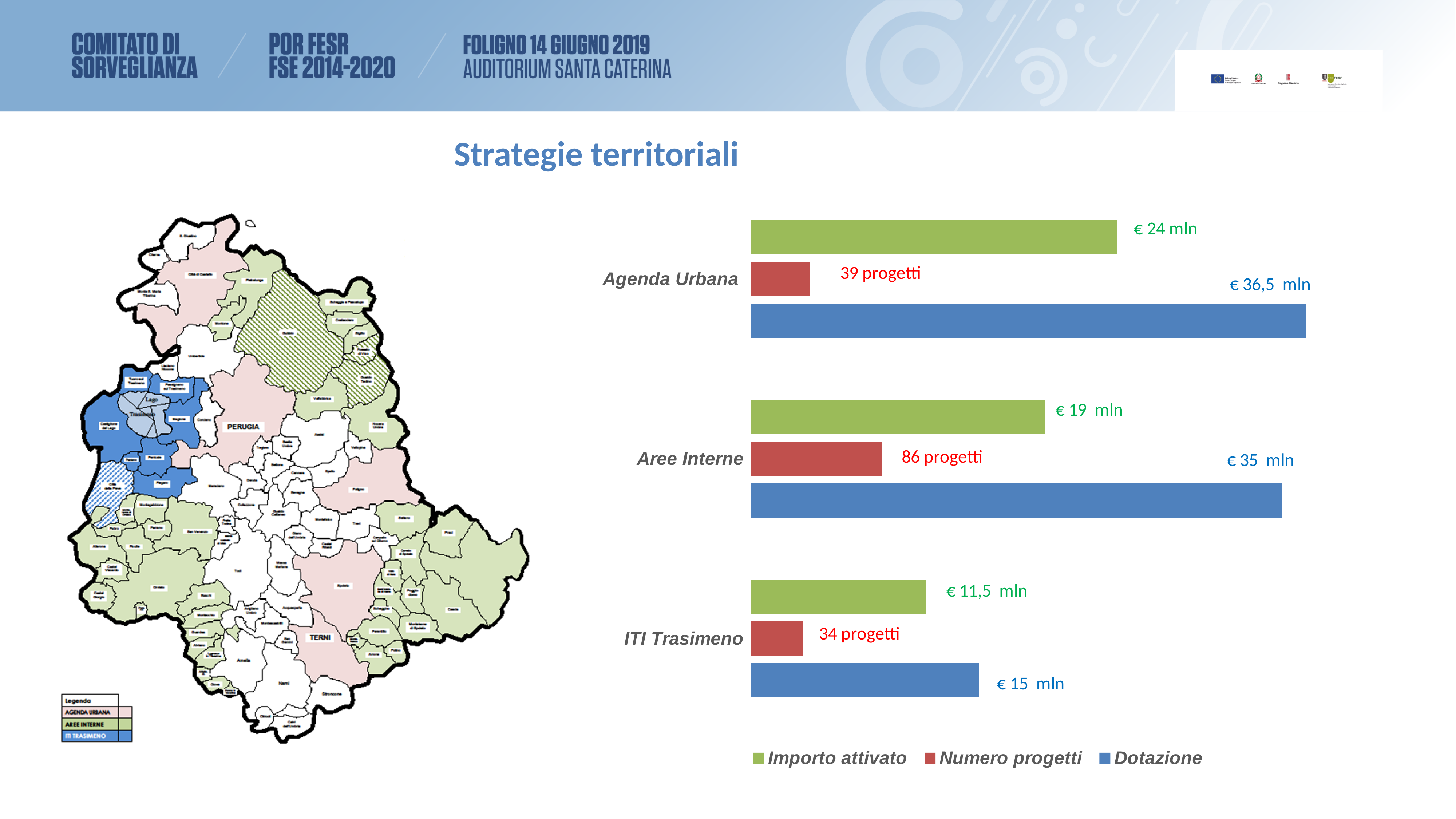
What is the Importo attivato value for Agenda Urbana? € 24 mln How many series does the chart legend list? 3 How many projects (Numero progetti) are shown for Aree Interne? 86 progetti What is the Dotazione value for Agenda Urbana? € 36,5 mln What is the difference between the Dotazione of Aree Interne and the Dotazione of ITI Trasimeno? € 20 mln What is the Dotazione value for ITI Trasimeno? € 15 mln What kind of chart is shown on the slide? Bar chart Which category has the highest Numero progetti? Aree Interne Which category has the lowest Importo attivato? ITI Trasimeno Which is larger: the Numero progetti for Agenda Urbana or for ITI Trasimeno? Agenda Urbana How many categories are shown on the chart? 3 Which colour represents the Dotazione series in the chart? Blue